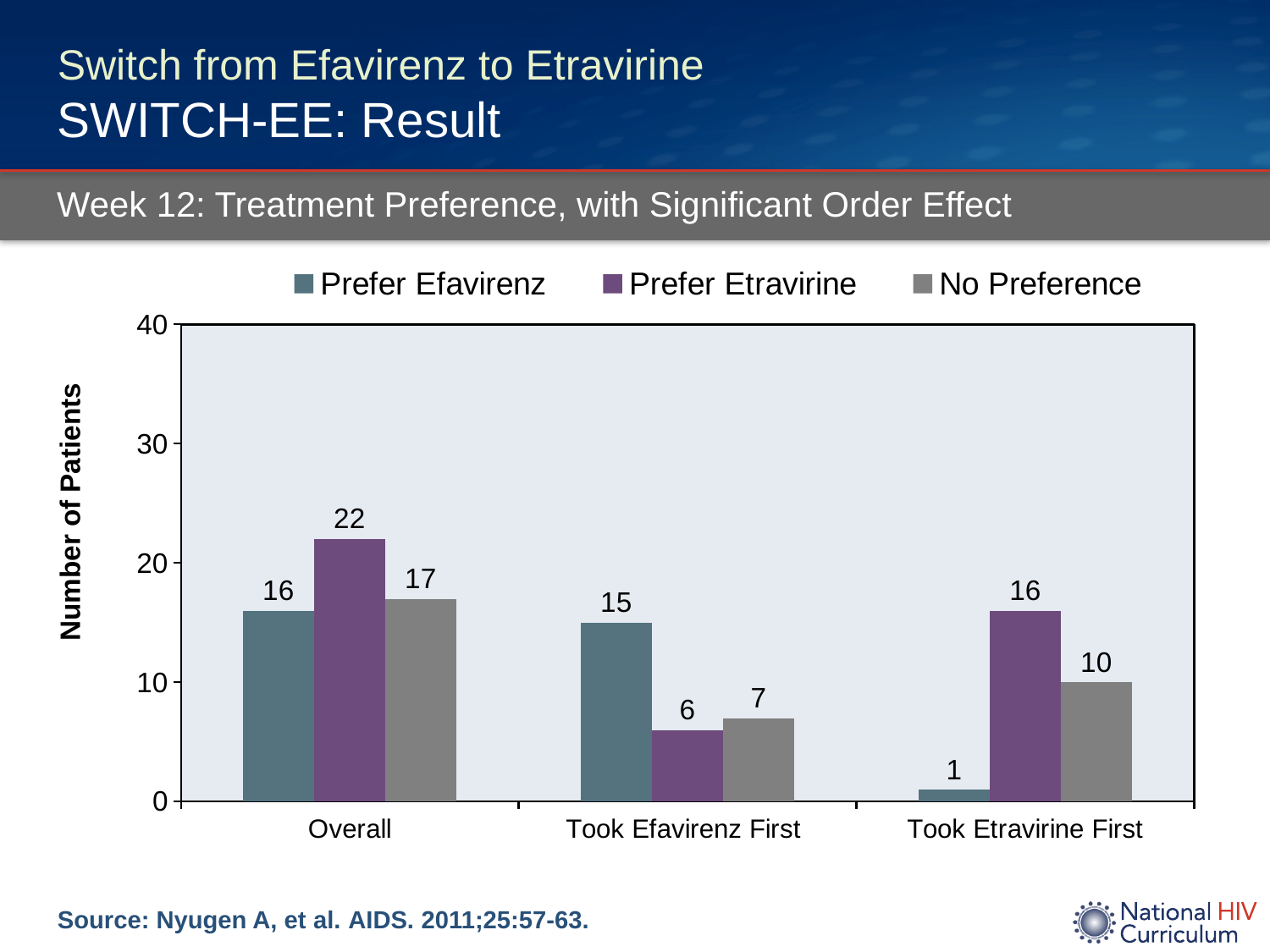
How many series does the legend list? 3 What is the total number of patients across the three preference groups in the Overall category? 55 How many patients who Took Efavirenz First preferred Efavirenz? 15 What is the difference between Prefer Etravirine and Prefer Efavirenz in the Took Etravirine First group? 15 In the Took Efavirenz First group, which is larger: Prefer Efavirenz or No Preference? Prefer Efavirenz Which category has the highest value for Prefer Etravirine? Overall How many categories are shown on the x axis? 3 Which category has the lowest value for Prefer Efavirenz? Took Etravirine First What kind of chart is shown on the slide? Bar chart What is the number of patients with No Preference among those who Took Etravirine First? 10 How many patients in the Overall group preferred Etravirine? 22 What is the label of the y axis? Number of Patients